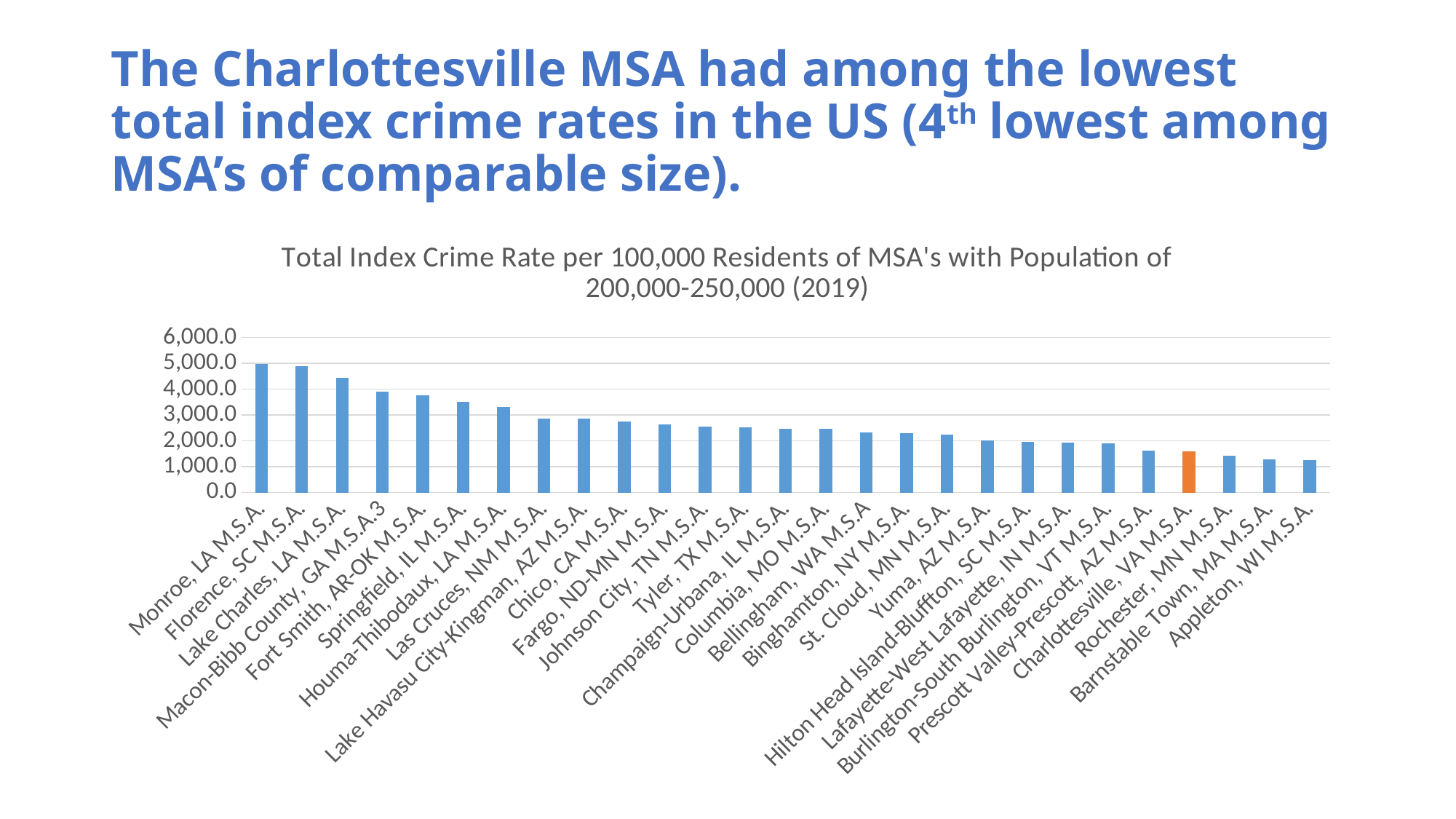
Is the value for Springfield, IL M.S.A. greater or less than 3,000.0? greater How many MSAs are plotted in the chart? 27 Is the value for Charlottesville, VA M.S.A. greater or less than 2,000.0? less What kind of chart is shown on the slide? Bar chart Is the value for Appleton, WI M.S.A. greater or less than 1,000.0? greater Which has a higher total index crime rate, Monroe, LA M.S.A. or Charlottesville, VA M.S.A.? Monroe, LA M.S.A. Which has a higher total index crime rate, Springfield, IL M.S.A. or Tyler, TX M.S.A.? Springfield, IL M.S.A. Do the crime rate values rise or fall moving from left to right along the x axis? Fall Which MSA's bar is highlighted in orange in the chart? Charlottesville, VA M.S.A.